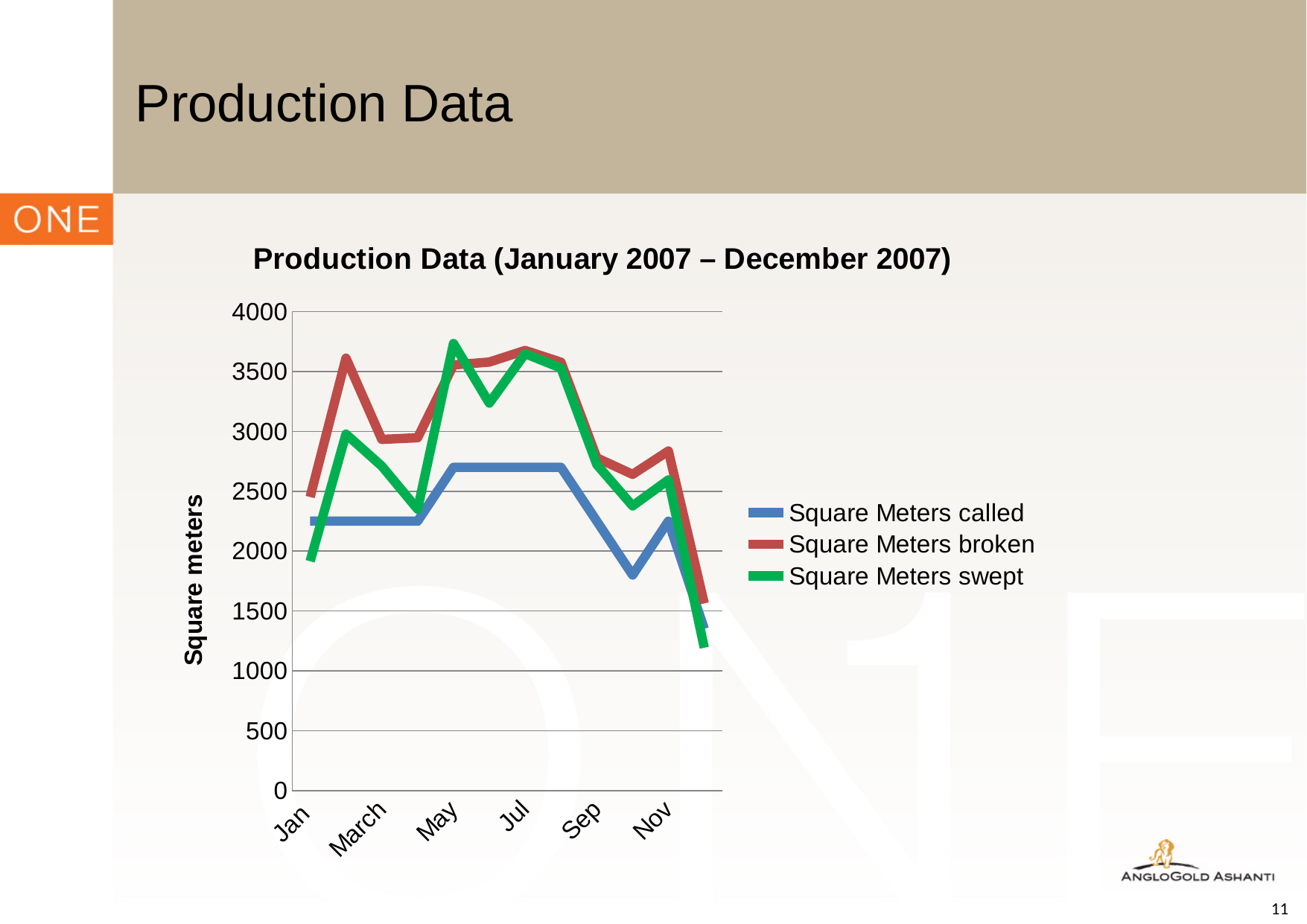
Is the value for Square Meters called in Jul greater or less than 2500? greater In which month is Square Meters called at its lowest? Dec In Jul, which is larger: Square Meters called or Square Meters swept? Square Meters swept Is the value for Square Meters swept in Jan greater or less than 2000? less Is the value for Square Meters called in Jan greater or less than 2000? greater What is the label on the vertical axis? Square meters In Jan, which is larger: Square Meters broken or Square Meters called? Square Meters broken From Jul to Sep, does Square Meters called rise or fall? fall What kind of chart is shown on the slide? line chart What is the title of the chart? Production Data (January 2007 – December 2007) How many series does the legend list? 3